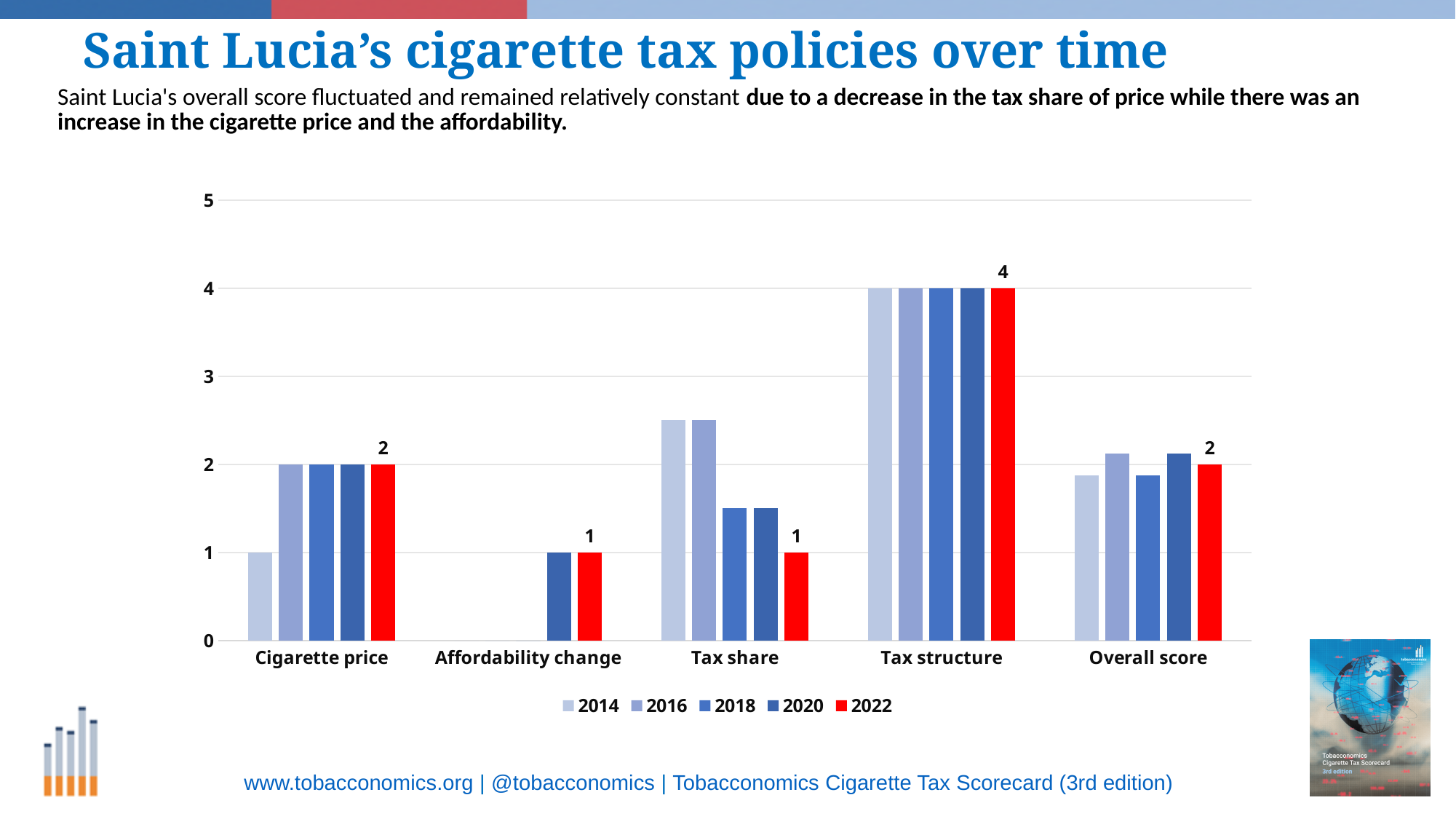
What is the value for Tax share in 2022? 1 What kind of chart is shown on the slide? bar chart Is the value for Tax share in 2014 greater or less than 2? greater Which category has the highest value in 2022? Tax structure What is the value for Overall score in 2022? 2 How many categories are shown on the x axis? 5 Which is larger in 2022: Tax structure or Overall score? Tax structure How many series does the legend list? 5 What is the value for Tax structure in 2022? 4 What is the value for Cigarette price in 2022? 2 Is the value for Tax share in 2018 greater or less than 2? less What is the difference between the 2022 values for Tax structure and Cigarette price? 2